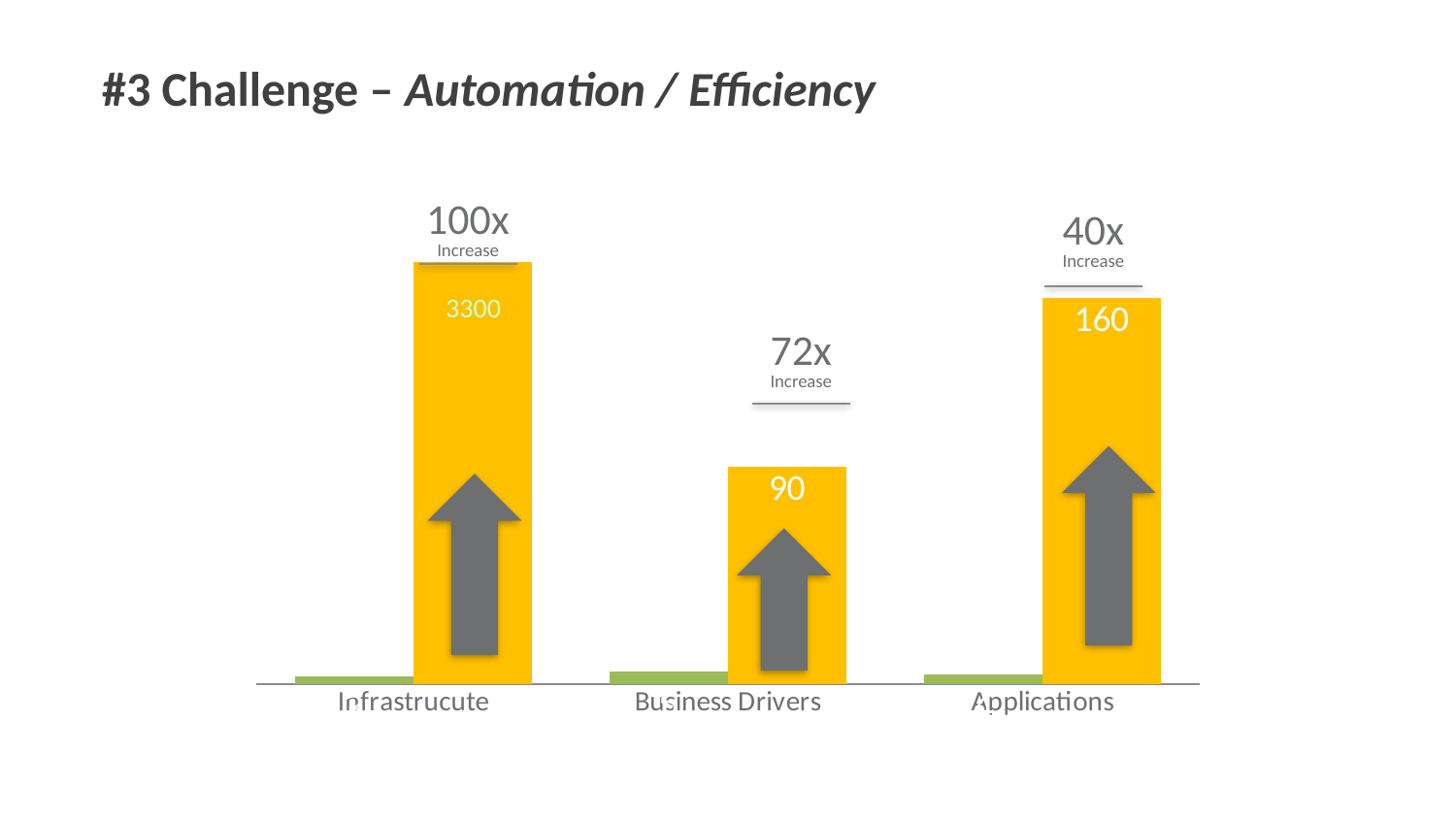
Which has the larger labelled value, Business Drivers or Applications? Applications What increase factor is annotated above the Business Drivers bar? 72x What increase factor is annotated above the Applications bar? 40x What is the difference between the labelled values for Infrastrucute and Applications? 3140 How many categories are shown on the x axis? 3 What is the value labelled on the yellow bar for Applications? 160 What is the value labelled on the yellow bar for Infrastrucute? 3300 What kind of chart is shown on the slide? Bar chart What is the value labelled on the yellow bar for Business Drivers? 90 What is the difference between the labelled values for Applications and Business Drivers? 70 Which category has the lowest labelled value? Business Drivers Which category has the highest labelled value? Infrastrucute